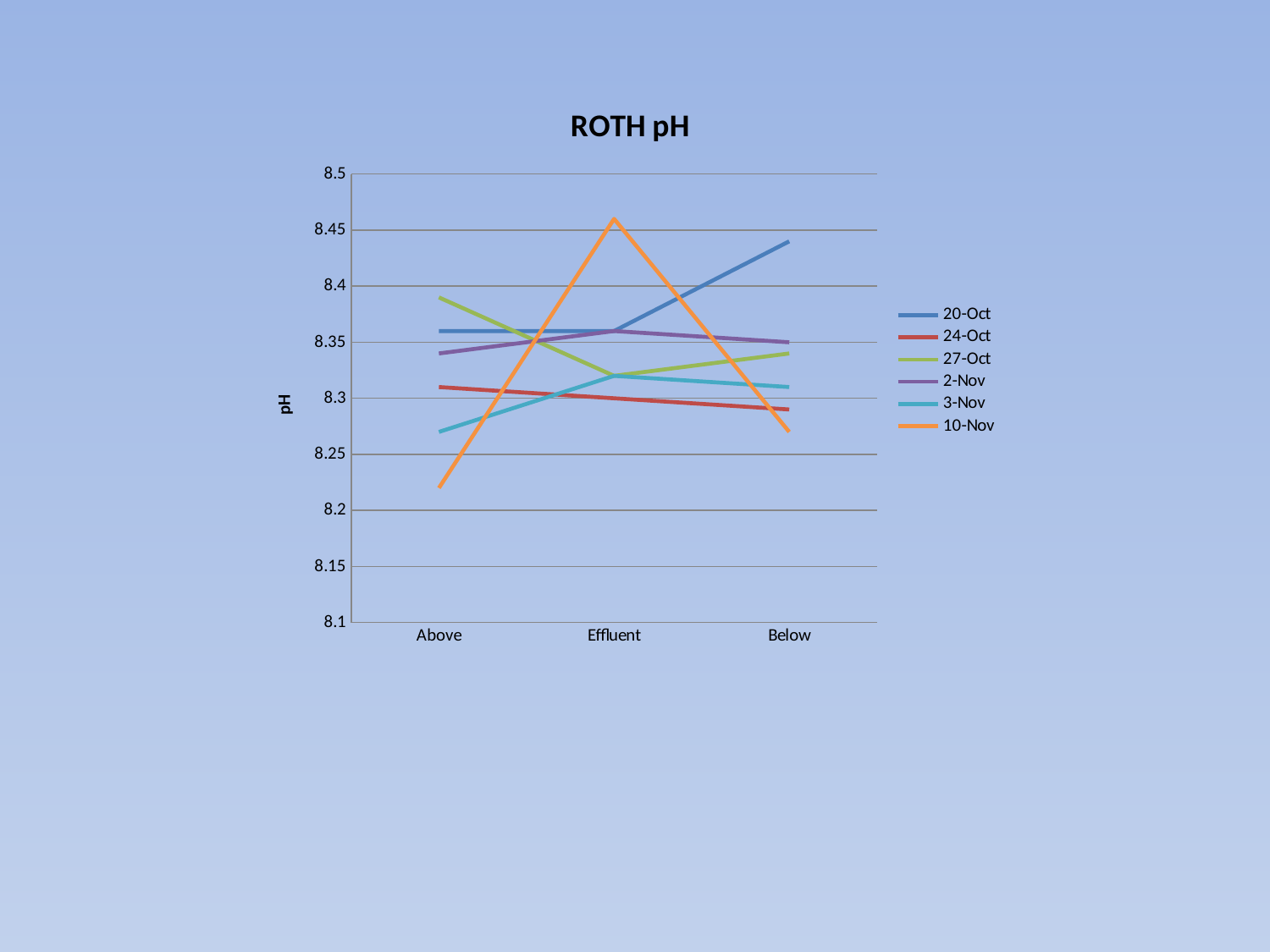
Which series has the highest value at Effluent? 10-Nov How many categories are shown on the x axis? 3 How many series does the legend list? 6 Which is larger at Below, the value for 20-Oct or the value for 24-Oct? 20-Oct What kind of chart is shown on the slide? line chart Is the value for 3-Nov at Above greater or less than 8.3? less Which series has the lowest value at Above? 10-Nov Is the value for 10-Nov at Effluent greater or less than 8.4? greater Which series has the highest value at Below? 20-Oct Is the value for 10-Nov at Above greater or less than 8.25? less Does the 24-Oct series rise or fall from Above to Below? fall What is the title of the chart? ROTH pH